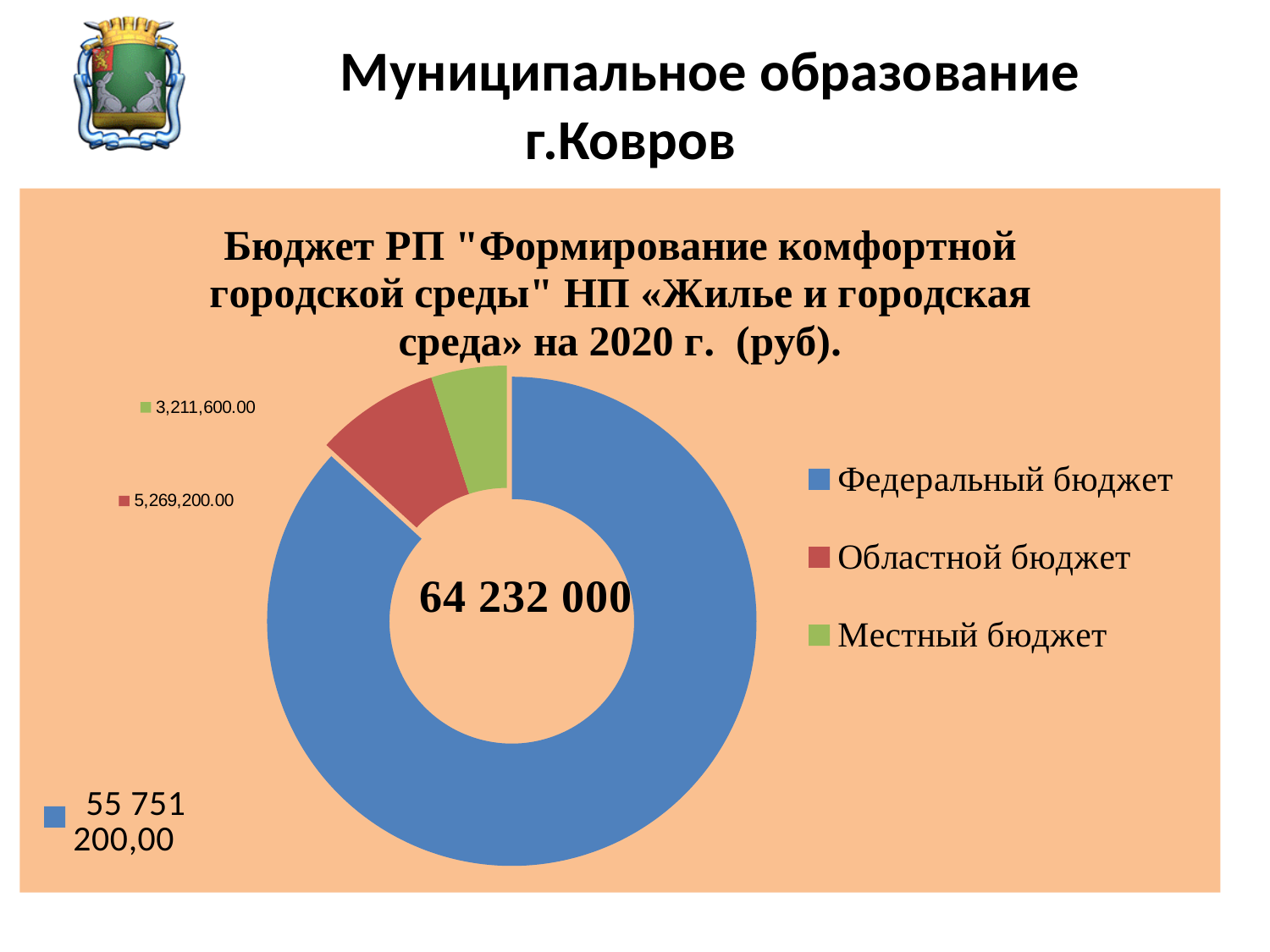
Which budget source has the largest share of the chart? Федеральный бюджет What kind of chart is shown on the slide? Doughnut (pie) chart What value is shown for Областной бюджет? 5,269,200.00 How many slices does the chart have? 3 What total is shown in the centre of the chart? 64 232 000 What value is shown for Местный бюджет? 3,211,600.00 What value is shown for Федеральный бюджет? 55 751 200,00 Which colour represents Областной бюджет in the chart? Red Which budget source has the smallest share of the chart? Местный бюджет Which is larger, the value for Областной бюджет or the value for Местный бюджет? Областной бюджет What share of the total does Местный бюджет represent? 5% What is the difference between the values for Областной бюджет and Местный бюджет? 2,057,600.00